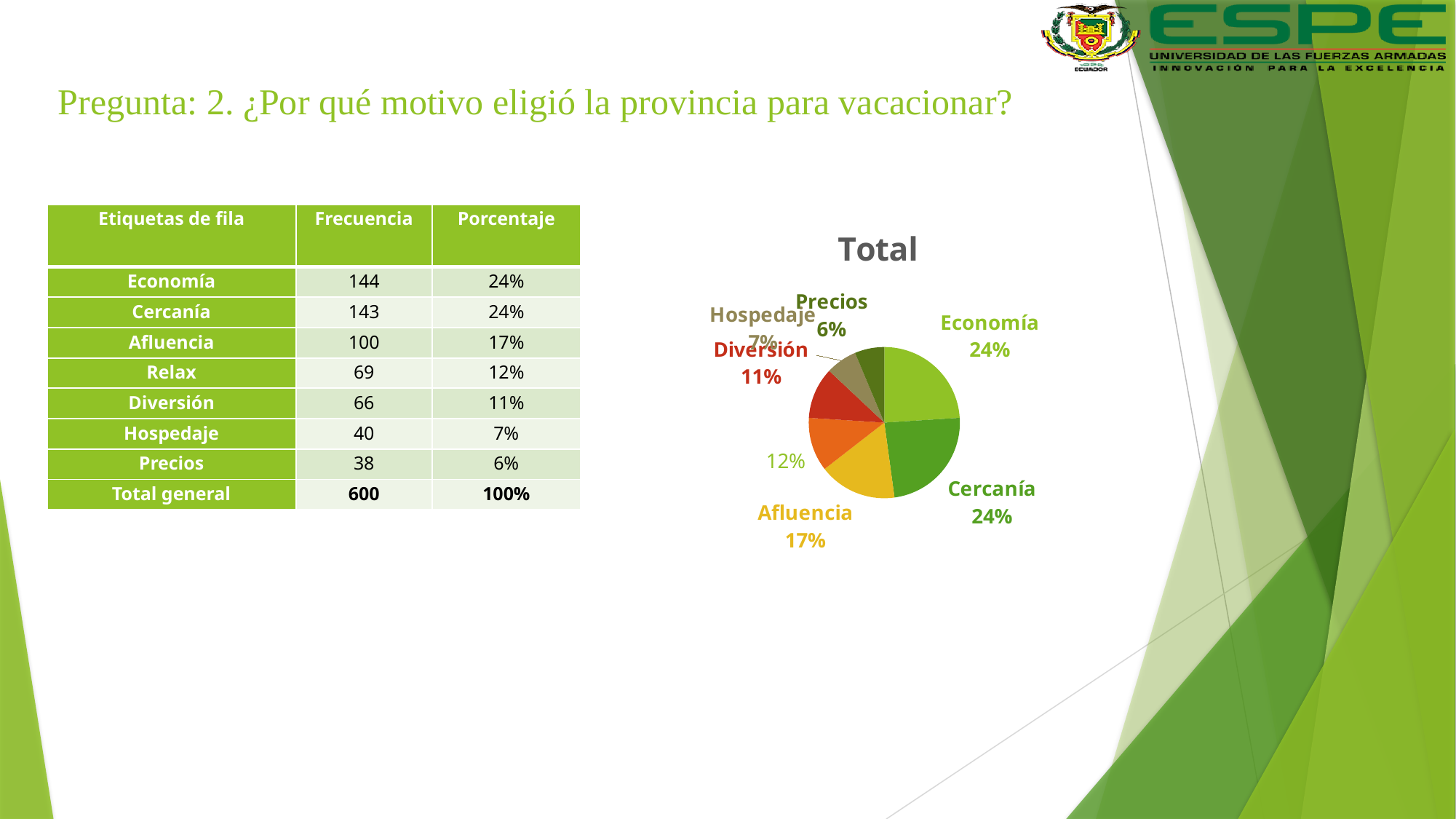
Which category has the smallest slice in the pie chart? Precios Which slice is larger in the pie chart, Hospedaje or Precios? Hospedaje What kind of chart is shown on the slide? pie chart How many slices does the pie chart have? 7 What percentage is shown for Hospedaje in the pie chart? 7% What is the title of the pie chart? Total What share of the pie does Economía represent? 24% What is the difference in percentage points between Diversión and Precios in the pie chart? 5 Which slice is larger in the pie chart, Afluencia or Diversión? Afluencia What percentage is shown for Diversión in the pie chart? 11% What share of the pie does Afluencia represent? 17% What is the difference in percentage points between Economía and Afluencia in the pie chart? 7